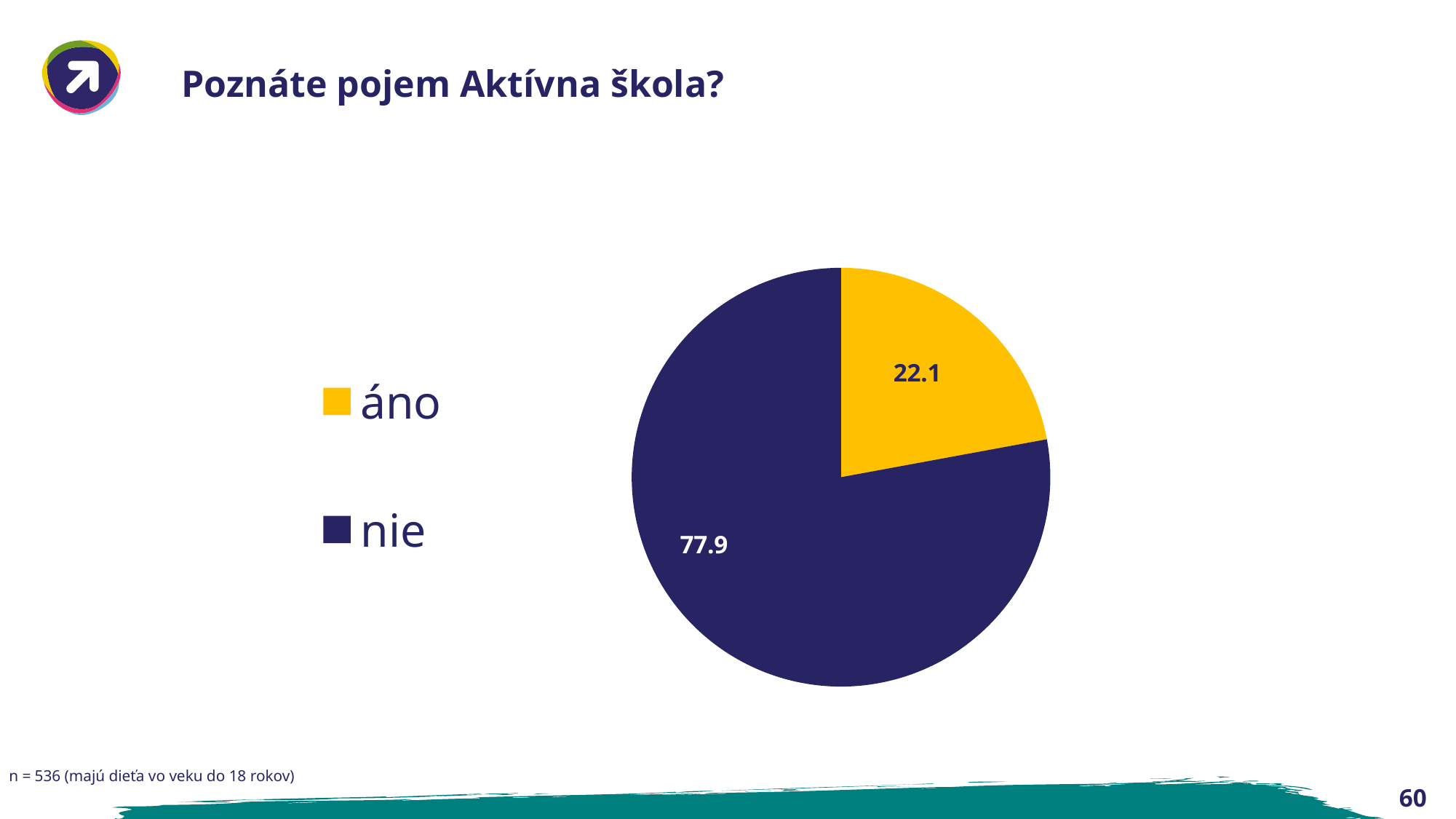
What is the value for "áno"? 22.1 Which category has the largest slice? nie How many entries does the legend list? 2 How many slices does the pie chart have? 2 What is the title of the slide above the chart? Poznáte pojem Aktívna škola? What is the difference between the values for "nie" and "áno"? 55.8 Which is larger, the value for "áno" or the value for "nie"? nie Which category has the smallest slice? áno What colour is the slice for "áno"? yellow What is the value for "nie"? 77.9 What kind of chart is shown on the slide? pie chart